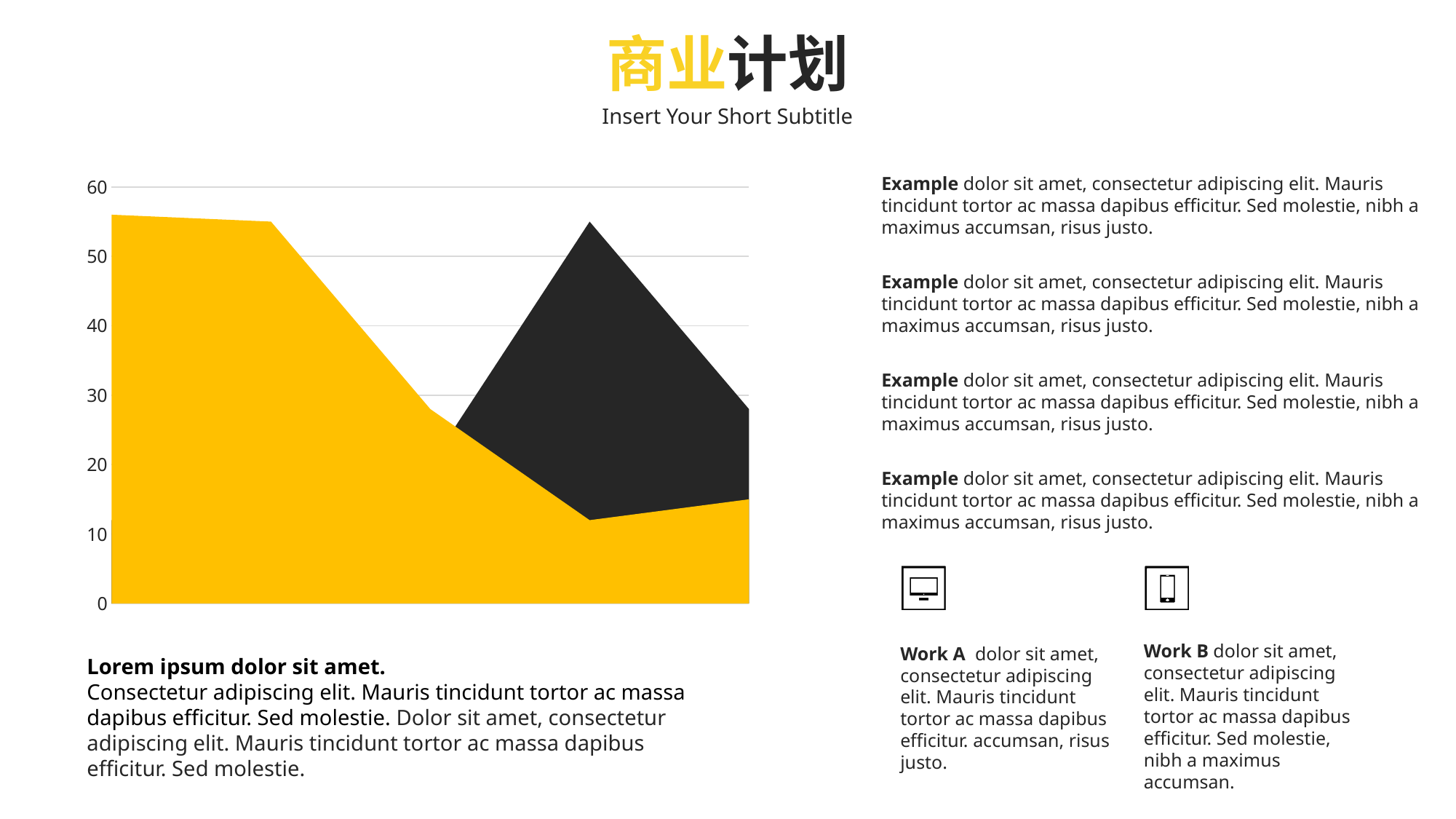
Is the value of the yellow area at the right edge of the chart greater or less than 20? less At the left edge of the chart, is the yellow area's value greater or less than 40? greater At the right edge of the chart, which area has the larger value, the yellow or the black? black Is the lowest value of the yellow area greater or less than 10? greater What kind of chart is shown on the slide? area chart Does the yellow area generally rise or fall from left to right across the chart? fall What is the highest value shown on the vertical axis of the chart? 60 What two colours are used for the filled areas in the chart? yellow and black